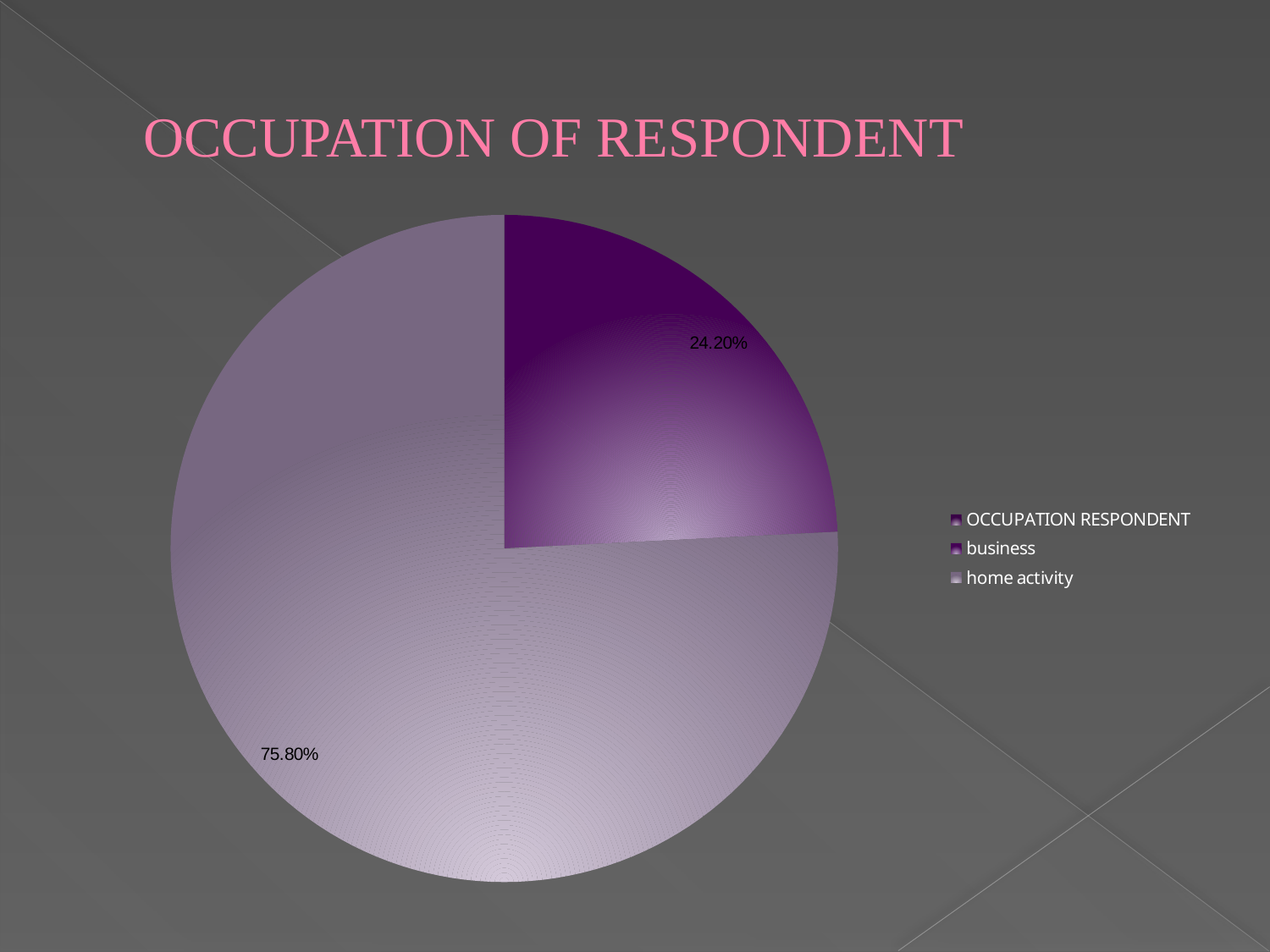
What percentage of the pie is labelled for the business slice? 24.20% How many entries does the legend list? 3 What is the title of the chart? OCCUPATION OF RESPONDENT What percentage of the pie is labelled for the home activity slice? 75.80% How many labelled slices are visible in the pie? 2 Which labelled slice of the pie is the smallest? business What is the first entry listed in the legend? OCCUPATION RESPONDENT What kind of chart is shown on the slide? pie chart Which slice of the pie is the largest? home activity What share of the pie does the home activity slice take? 75.80% What is the difference between the home activity share and the business share? 51.60% Which is larger, the business slice or the home activity slice? home activity